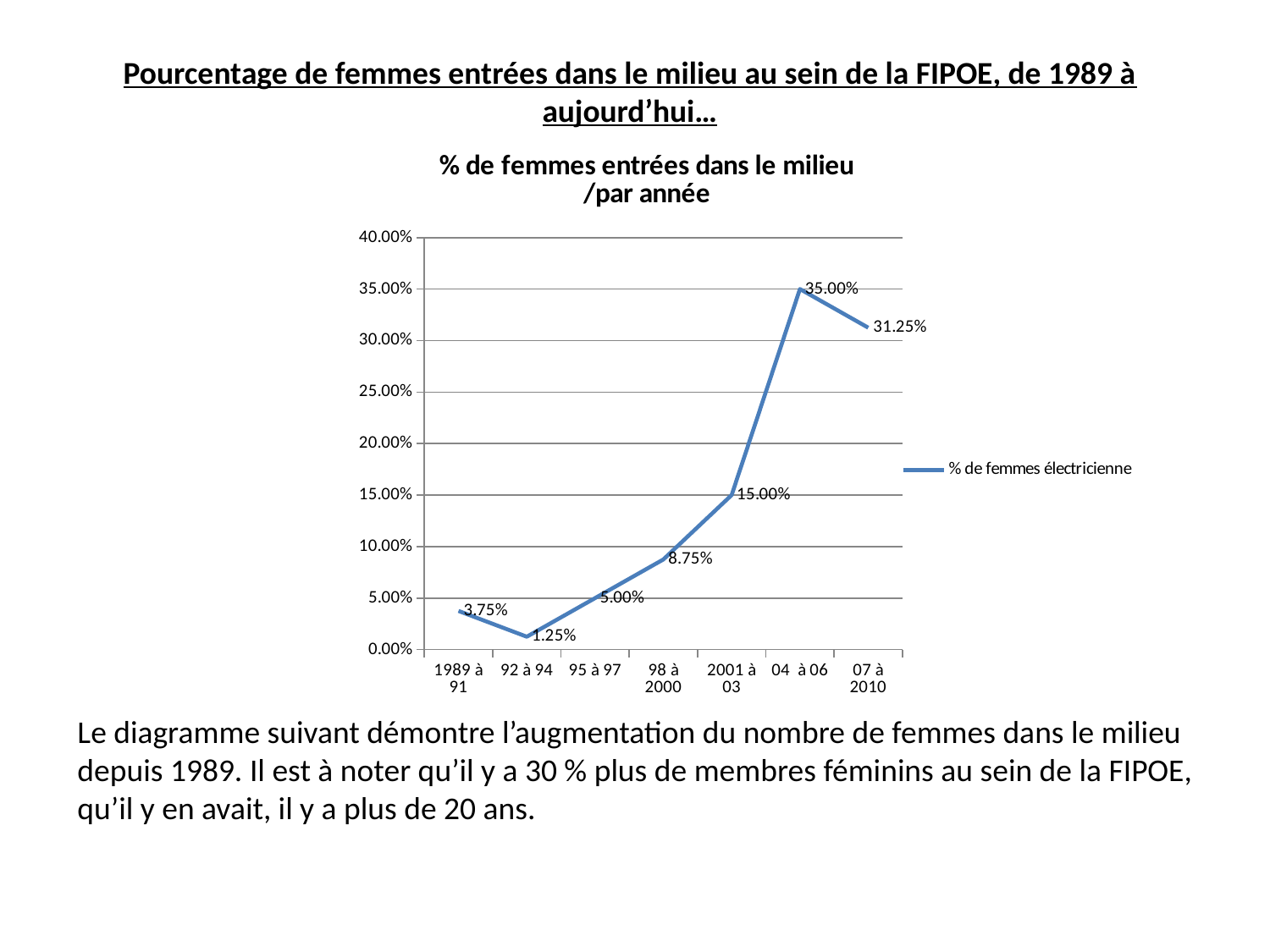
How many periods are plotted on the x axis? 7 What is the difference between the values for 04 à 06 and 2001 à 03? 20.00% Which period has the highest value? 04 à 06 What is the title of the chart? % de femmes entrées dans le milieu /par année What is the value for 1989 à 91? 3.75% What is the value for 07 à 2010? 31.25% What is the value for 92 à 94? 1.25% Which period has the lowest value? 92 à 94 What kind of chart is shown on the slide? line chart How many series does the legend list? 1 Which is larger, the value for 98 à 2000 or the value for 95 à 97? 98 à 2000 What is the value for 2001 à 03? 15.00%